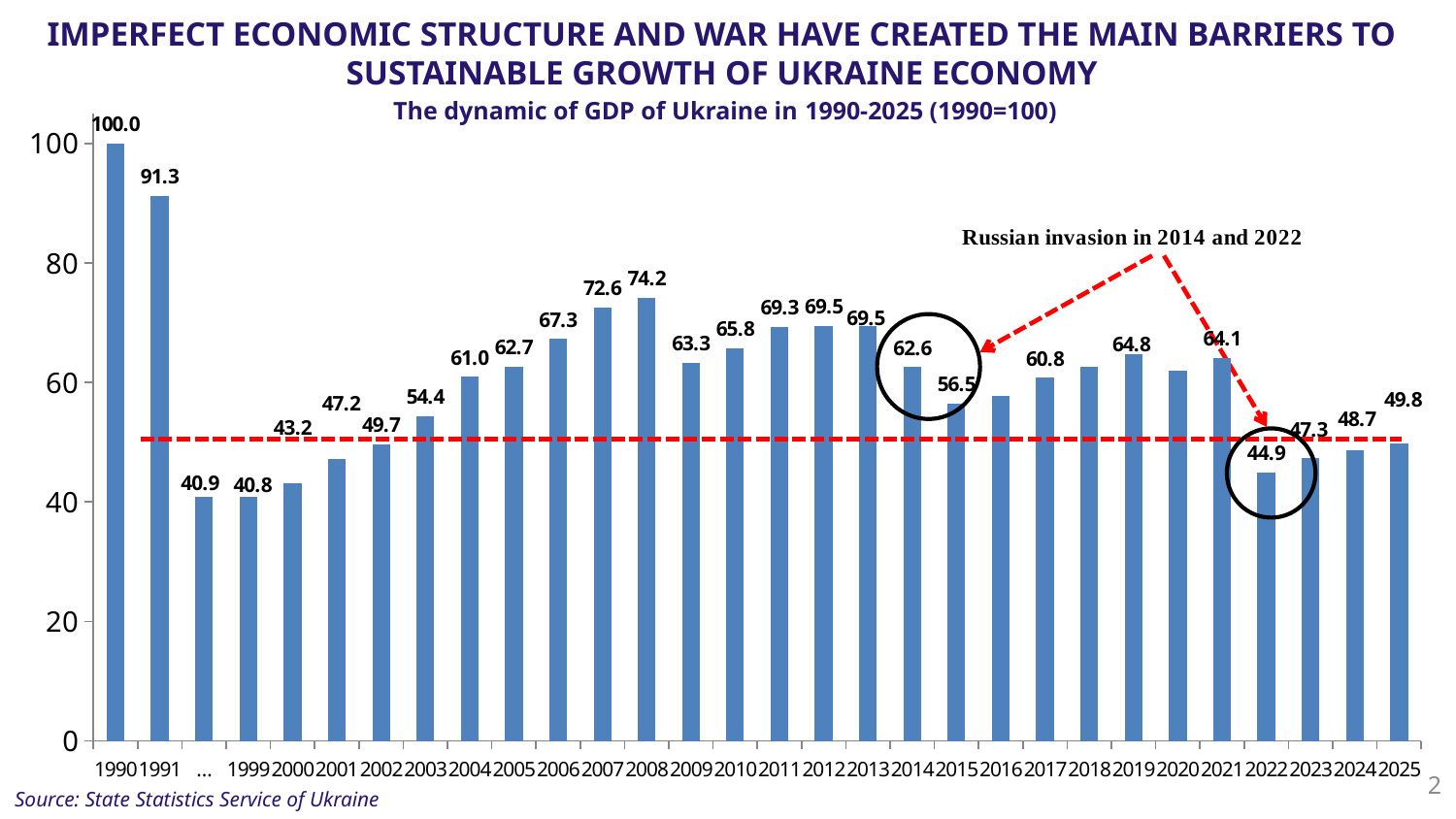
Is the value for 2016 greater or less than 60? less Which year from 2020 onward has the lowest value? 2022 Which is larger, the value for 2013 or the value for 2014? 2013 Which year has the highest value in the chart? 1990 Do the values rise or fall from 2022 to 2025? rise What is the value shown for 2008? 74.2 What is the difference between the values for 2008 and 2007? 1.6 What kind of chart is shown on the slide? bar chart What is the value shown for 2025? 49.8 What is the GDP index value for 1990? 100.0 What is the difference between the values for 2021 and 2022? 19.2 What is the value shown for 2022? 44.9